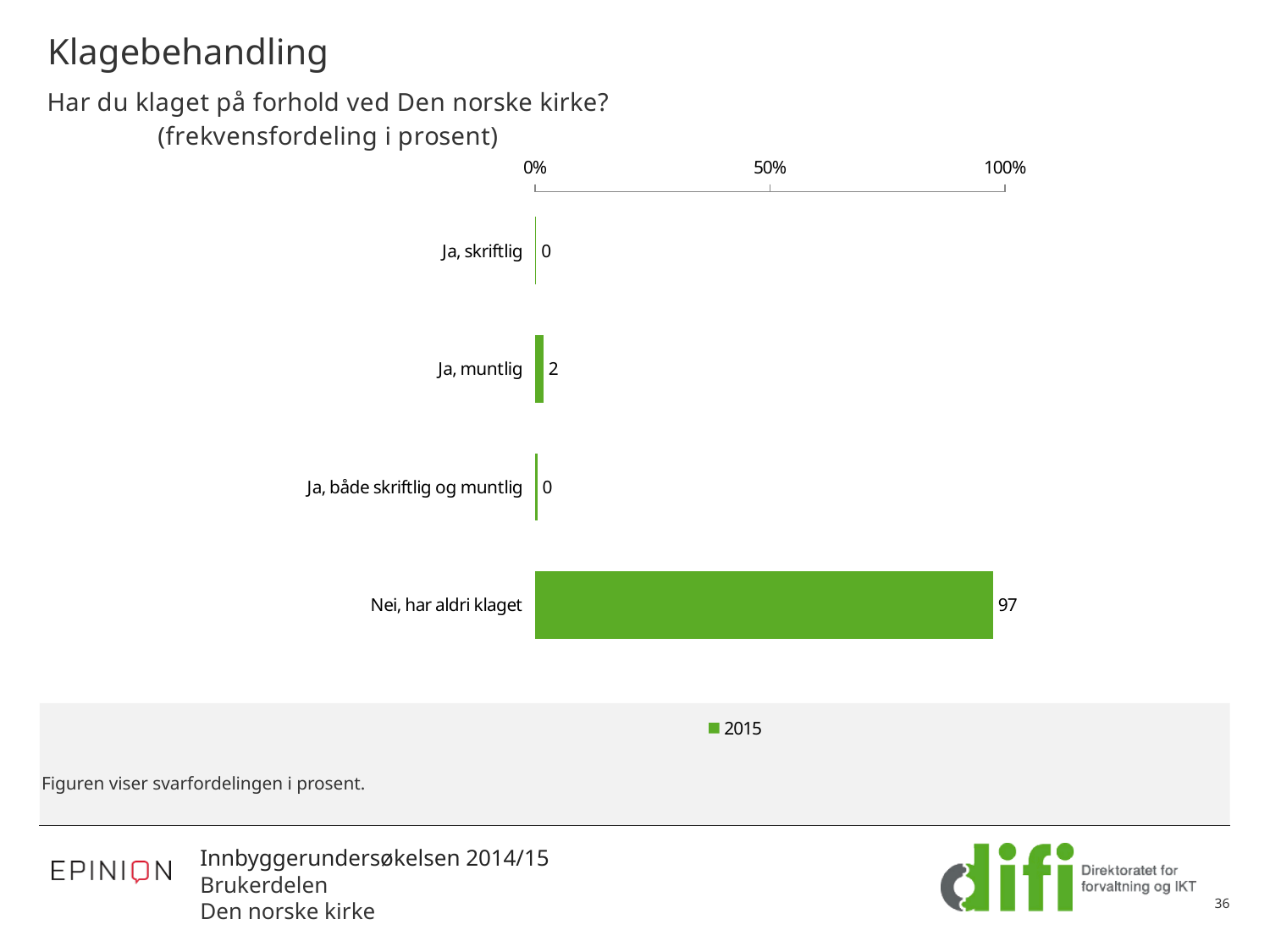
What series name is shown in the legend? 2015 What is the difference between the values for "Nei, har aldri klaget" and "Ja, muntlig"? 95 What is the value for "Ja, både skriftlig og muntlig"? 0 What is the value for "Ja, muntlig"? 2 What kind of chart is shown on the slide? Bar chart Which category has the highest value? Nei, har aldri klaget Is the value for "Nei, har aldri klaget" greater or less than 50%? greater What is the value for "Nei, har aldri klaget"? 97 Which is larger, the value for "Ja, muntlig" or the value for "Ja, skriftlig"? Ja, muntlig How many categories are shown in the chart? 4 How many series does the legend list? 1 What is the value for "Ja, skriftlig"? 0